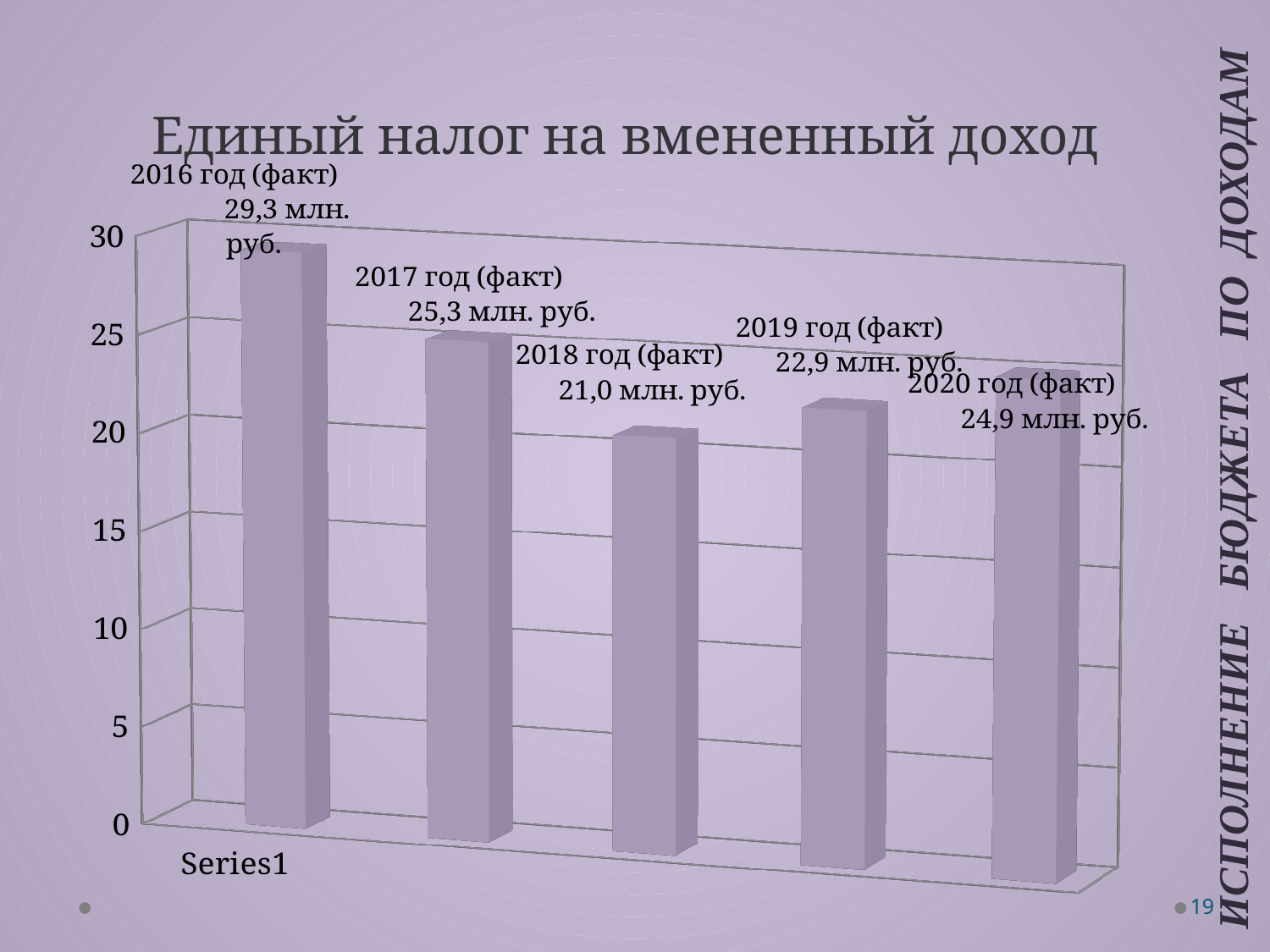
What kind of chart is shown on the slide? bar chart What is the title of the chart? Единый налог на вмененный доход What is the value for 2020 год (факт)? 24,9 млн. руб. Which year has the highest value? 2016 год (факт) What is the value for 2016 год (факт)? 29,3 млн. руб. What is the difference between the values for 2016 год (факт) and 2017 год (факт)? 4,0 млн. руб. Which year has the lowest value? 2018 год (факт) What is the difference between the values for 2020 год (факт) and 2019 год (факт)? 2,0 млн. руб. What is the value for 2018 год (факт)? 21,0 млн. руб. Is the value for 2018 год (факт) greater or less than 25? less Which is larger, the value for 2019 год (факт) or 2020 год (факт)? 2020 год (факт) How many bars are shown in the chart? 5